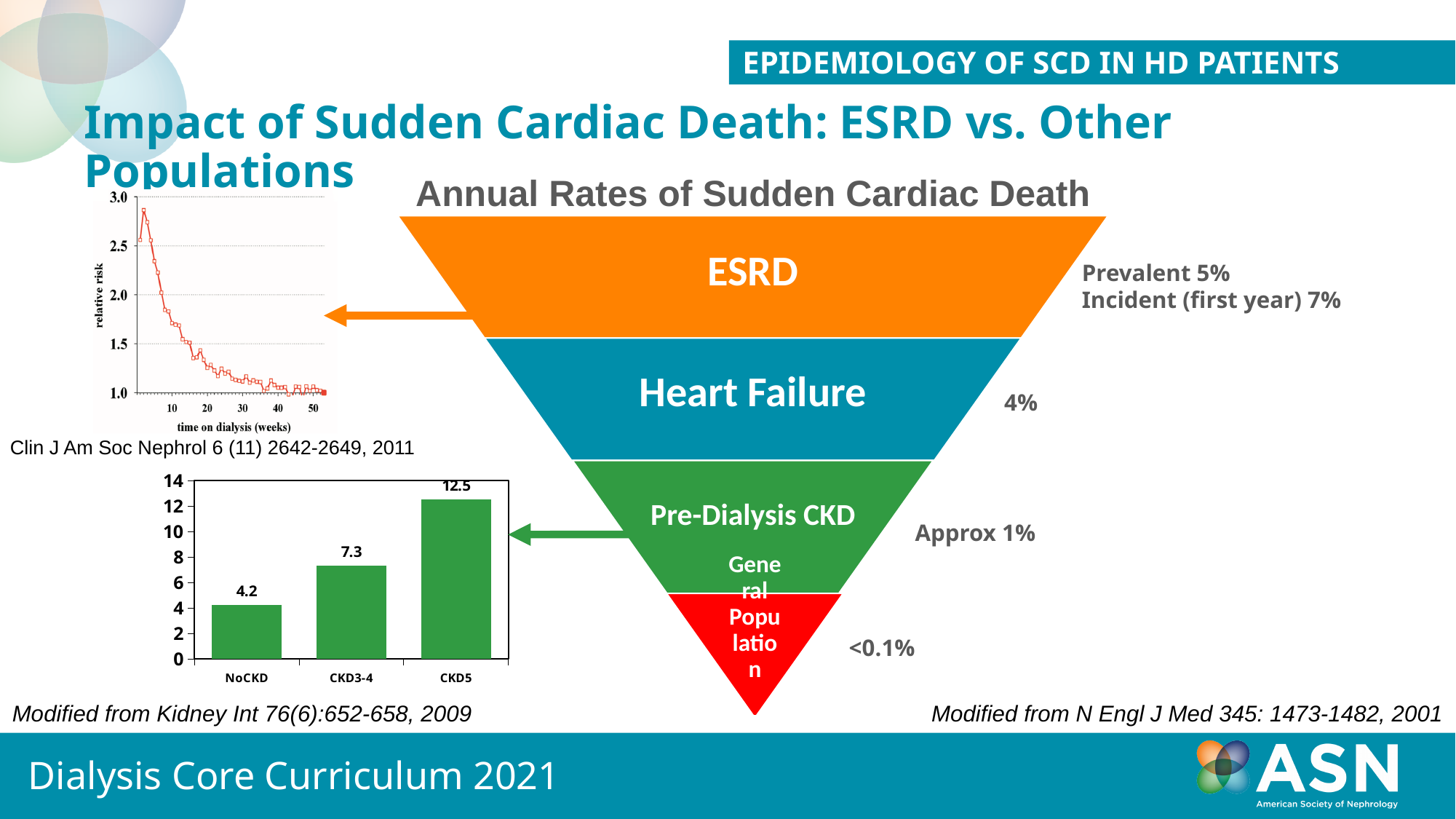
In the bar chart at the bottom left, which category has the highest value? CKD5 In the line chart at the top left, does relative risk rise or fall as time on dialysis increases? Fall In the bar chart at the bottom left, do the values rise or fall from NoCKD to CKD5? Rise In the bar chart at the bottom left, what is the difference between the values for CKD5 and NoCKD? 8.3 In the bar chart at the bottom left, what is the value for CKD5? 12.5 In the bar chart at the bottom left, which category has the lowest value? NoCKD In the line chart at the top left, is the relative risk at 40 weeks on dialysis greater or less than 1.5? less In the bar chart at the bottom left, what is the value for CKD3-4? 7.3 In the bar chart at the bottom left, which is larger, the value for CKD3-4 or the value for NoCKD? CKD3-4 In the bar chart at the bottom left, what is the value for NoCKD? 4.2 What kind of chart is the one at the bottom left with NoCKD, CKD3-4 and CKD5? Bar chart How many categories are shown in the bar chart at the bottom left? 3